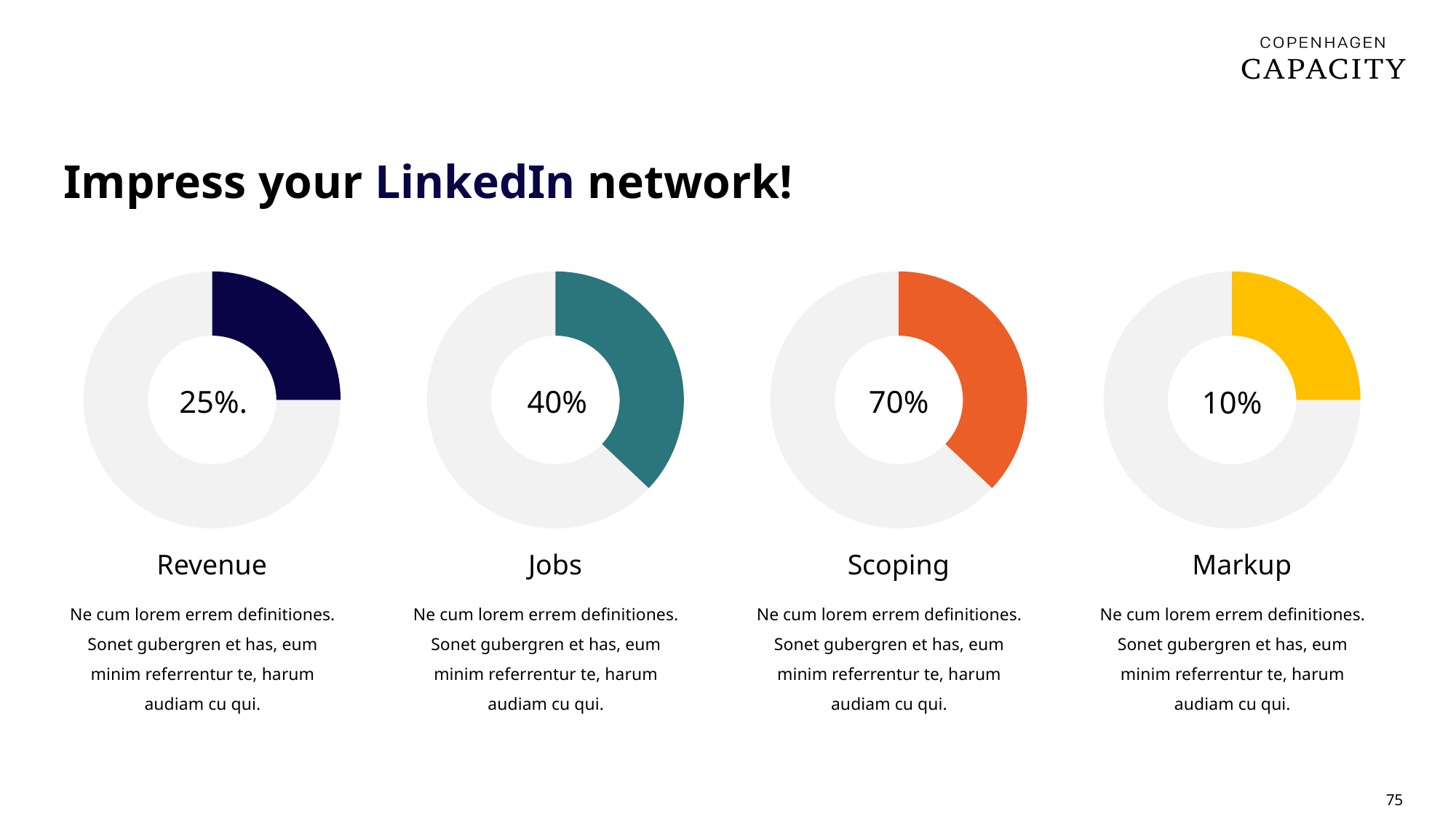
What type of chart is used for the Scoping figure? Donut chart Which is larger, the Jobs percentage or the Revenue percentage? Jobs Which of the four donut charts shows the lowest percentage? Markup What colour is the filled segment of the Markup donut chart? Yellow What is the difference between the Revenue percentage and the Markup percentage? 15% What is the difference between the Scoping percentage and the Jobs percentage? 30% What percentage is shown in the Jobs donut chart? 40% What percentage is shown in the Markup donut chart? 10% How many donut charts are shown on the slide? 4 What percentage is shown in the Scoping donut chart? 70% What percentage is shown in the Revenue donut chart? 25% Which of the four donut charts shows the highest percentage? Scoping